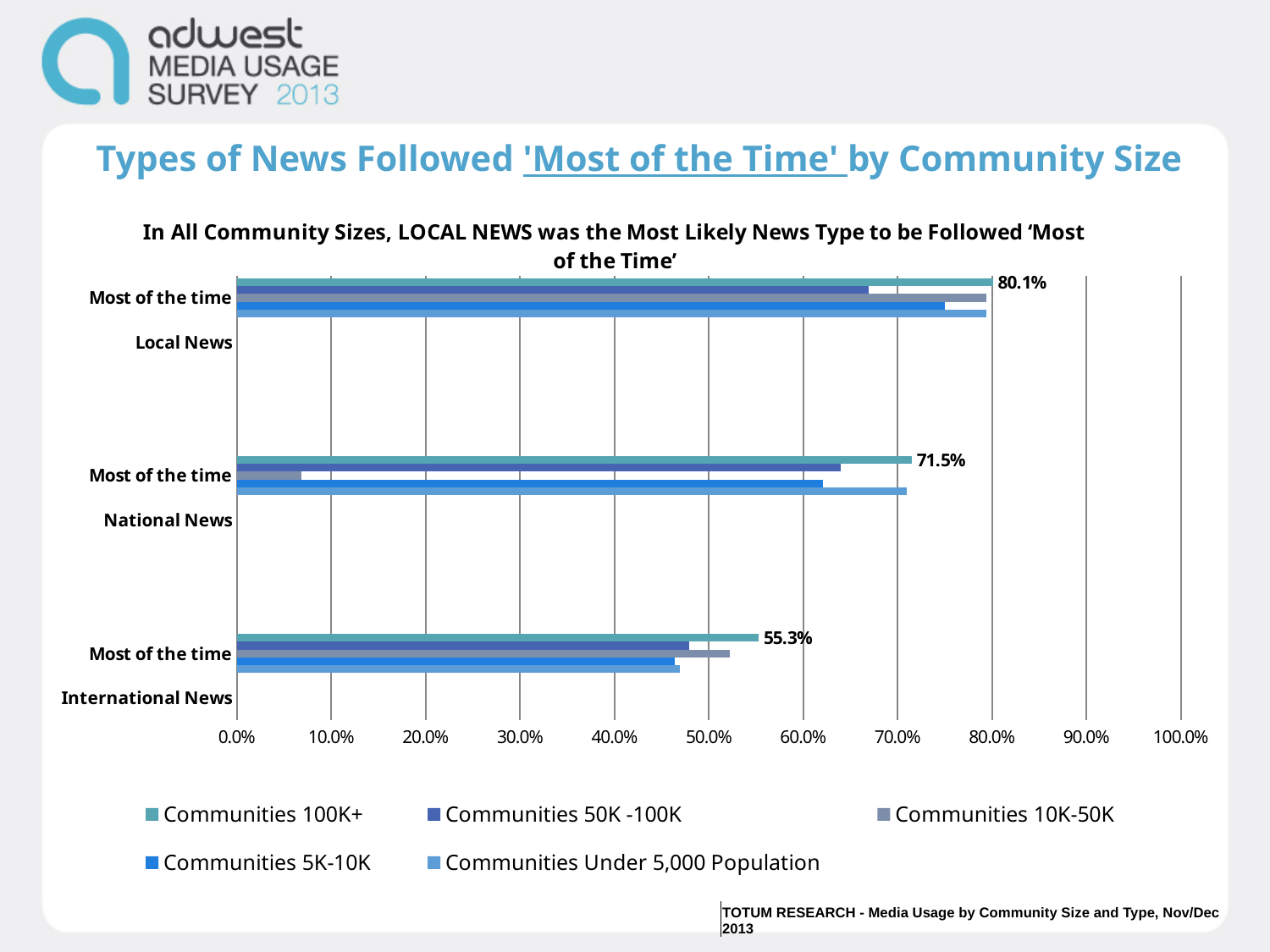
Is the value for Communities 10K-50K for National News greater or less than 10.0%? less What is the value for Communities 100K+ for National News? 71.5% What is the value for Communities 100K+ for International News? 55.3% For Communities 100K+, which news type has the highest value? Local News Is the value for Communities 50K -100K for Local News greater or less than 60.0%? greater What is the value for Communities 100K+ for Local News? 80.1% What is the difference between the Communities 100K+ values for Local News and International News? 24.8 percentage points For Communities 100K+, which news type has the lowest value? International News For Communities 100K+, which is larger: the value for Local News or for National News? Local News What kind of chart is shown on the slide? Bar chart How many series does the legend list? 5 How many news types are shown on the chart? 3